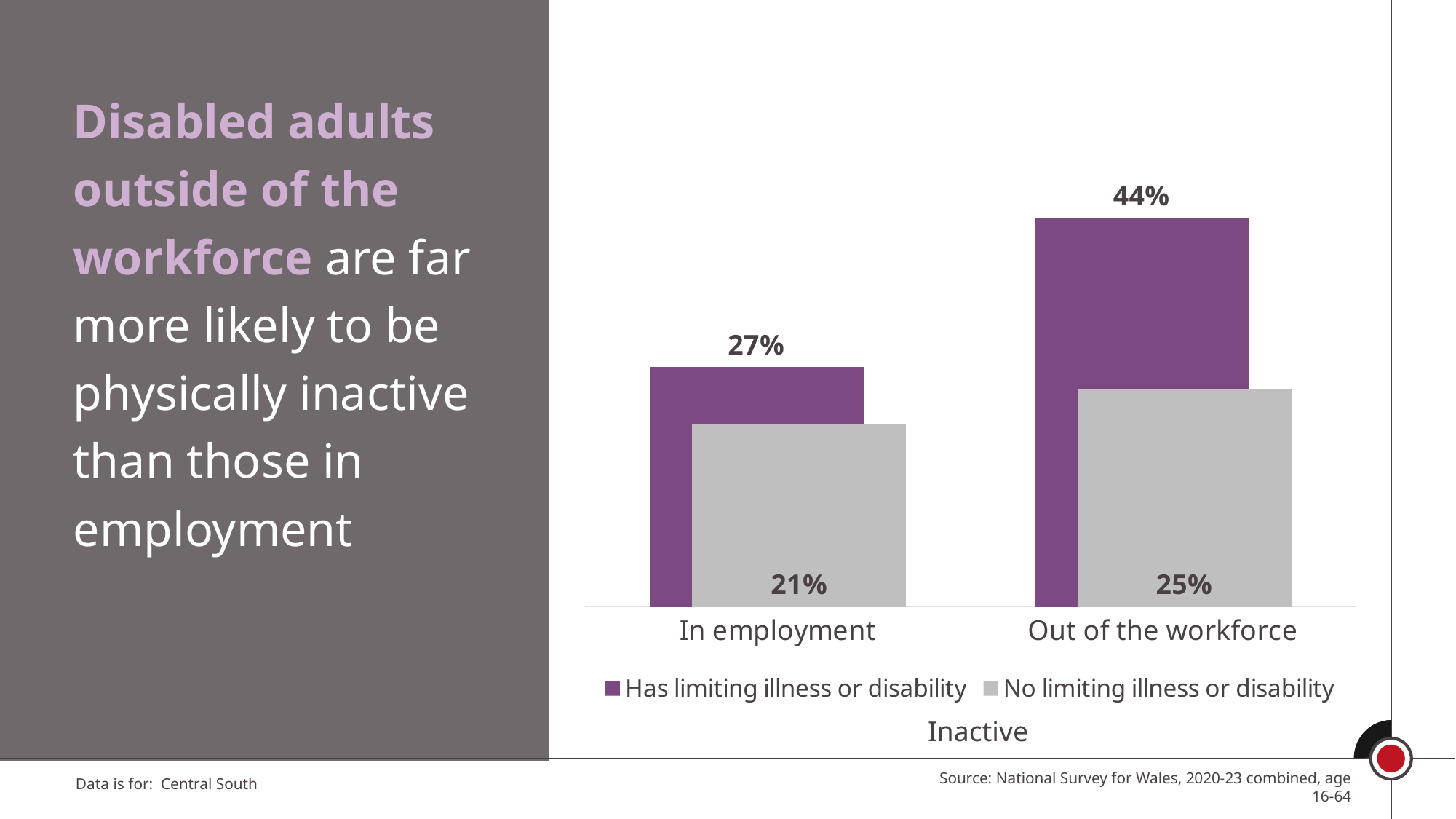
Which bar shows the highest inactive percentage on the chart? Has limiting illness or disability, Out of the workforce Which bar shows the lowest inactive percentage on the chart? No limiting illness or disability, In employment How many categories are shown on the x axis of the chart? 2 What type of chart is shown on the slide? Bar chart What is the inactive percentage for people out of the workforce with no limiting illness or disability? 25% What is the difference between the two 'Has limiting illness or disability' bars (Out of the workforce minus In employment)? 17% How many series does the chart legend list? 2 Which is larger: the 'No limiting illness or disability' value for 'In employment' or for 'Out of the workforce'? Out of the workforce What percentage of people in employment who have a limiting illness or disability are inactive? 27% In the 'In employment' category, what is the difference between the 'Has limiting illness or disability' and 'No limiting illness or disability' values? 6% What is the value for 'No limiting illness or disability' in the 'In employment' category? 21% What is the value for 'Has limiting illness or disability' in the 'Out of the workforce' category? 44%